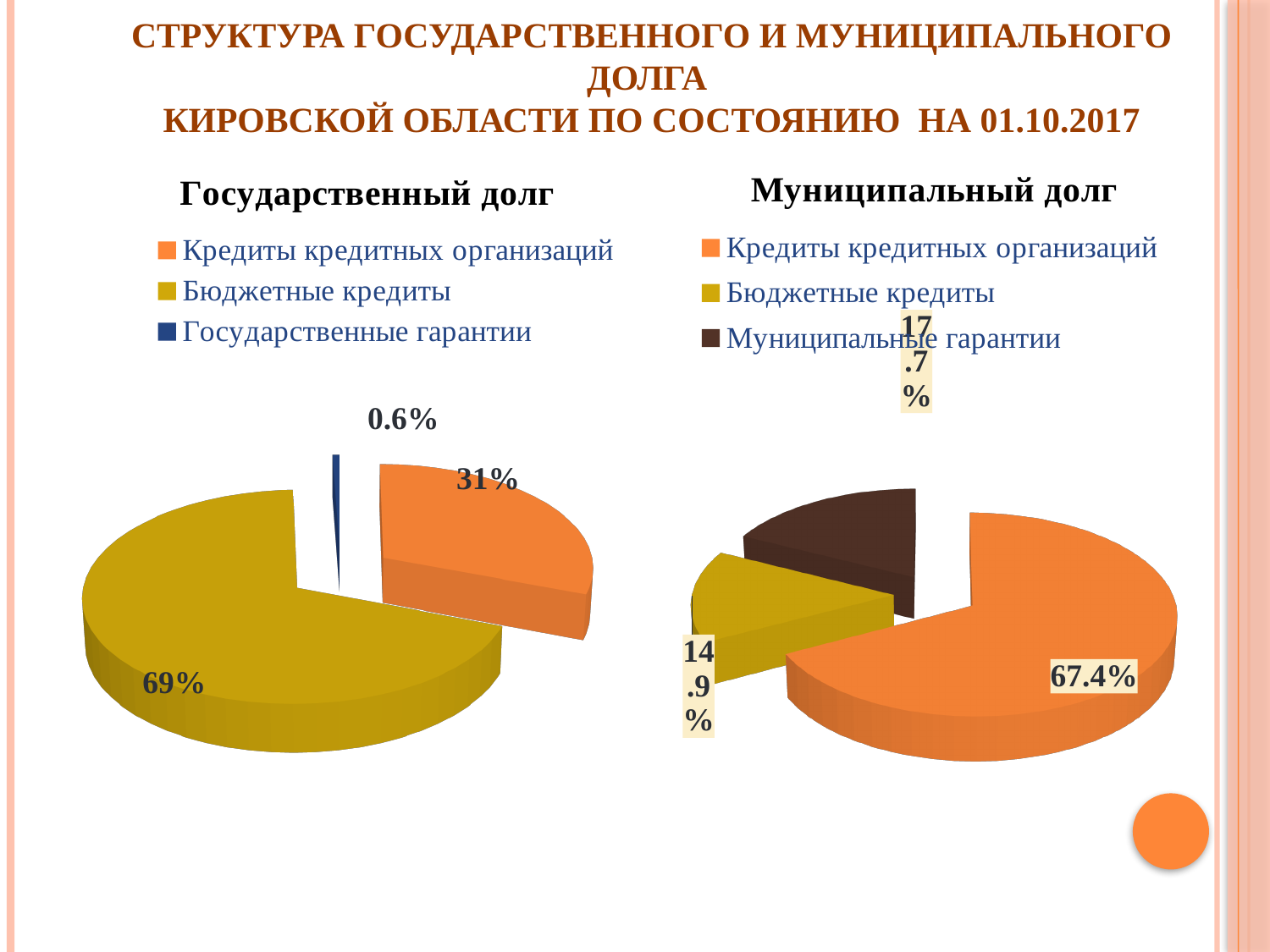
In the "Муниципальный долг" chart, what share is shown for "Бюджетные кредиты"? 14.9% In the "Муниципальный долг" chart, which category has the largest slice? Кредиты кредитных организаций In the "Муниципальный долг" chart, what is the difference between the shares of "Муниципальные гарантии" and "Бюджетные кредиты"? 2.8% In the "Государственный долг" chart, what share is shown for "Бюджетные кредиты"? 69% In the "Муниципальный долг" chart, what share is shown for "Муниципальные гарантии"? 17.7% In the "Муниципальный долг" chart, what share is shown for "Кредиты кредитных организаций"? 67.4% In the "Государственный долг" chart, which category has the smallest slice? Государственные гарантии In the "Государственный долг" chart, what share is shown for "Кредиты кредитных организаций"? 31% What kind of chart is used for "Государственный долг"? Pie chart In the "Государственный долг" chart, what share is shown for "Государственные гарантии"? 0.6% In the "Государственный долг" chart, which category has the largest slice? Бюджетные кредиты How many categories does the legend of the "Муниципальный долг" chart list? 3